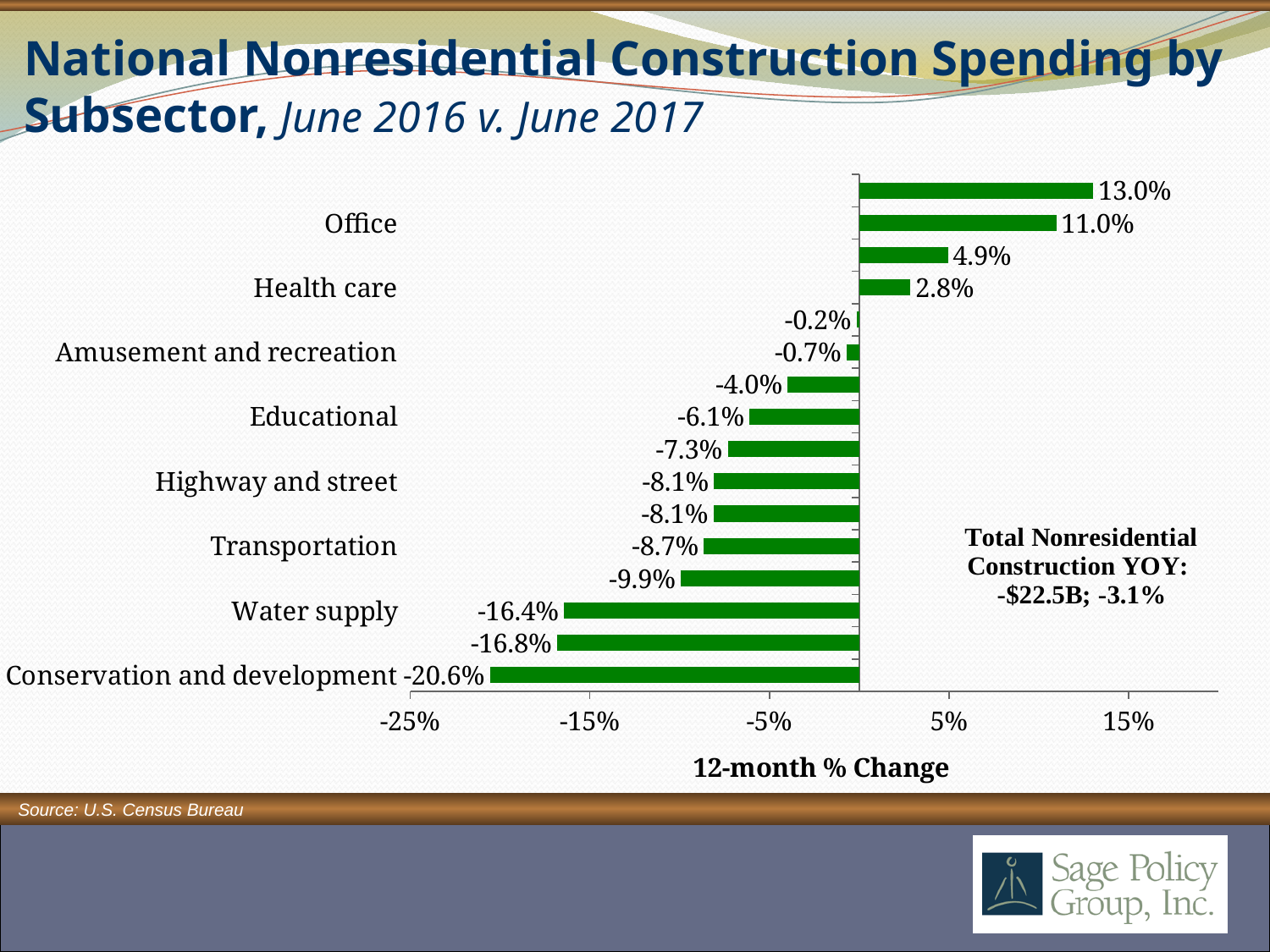
What is the 12-month % change for Health care? 2.8% What is the title of the horizontal axis? 12-month % Change How many bars are plotted in the chart? 16 What is the 12-month % change for Water supply? -16.4% What is the 12-month % change for Office? 11.0% What is the difference in 12-month % change between Office and Health care? 8.2 percentage points Is the value for Water supply greater or less than -15%? less What is the 12-month % change for Conservation and development? -20.6% Which has the larger 12-month % change, Educational or Transportation? Educational According to the text box on the chart, what is the total nonresidential construction year-over-year change? -$22.5B; -3.1% What kind of chart is shown on the slide? Bar chart Which labeled subsector has the lowest 12-month % change? Conservation and development